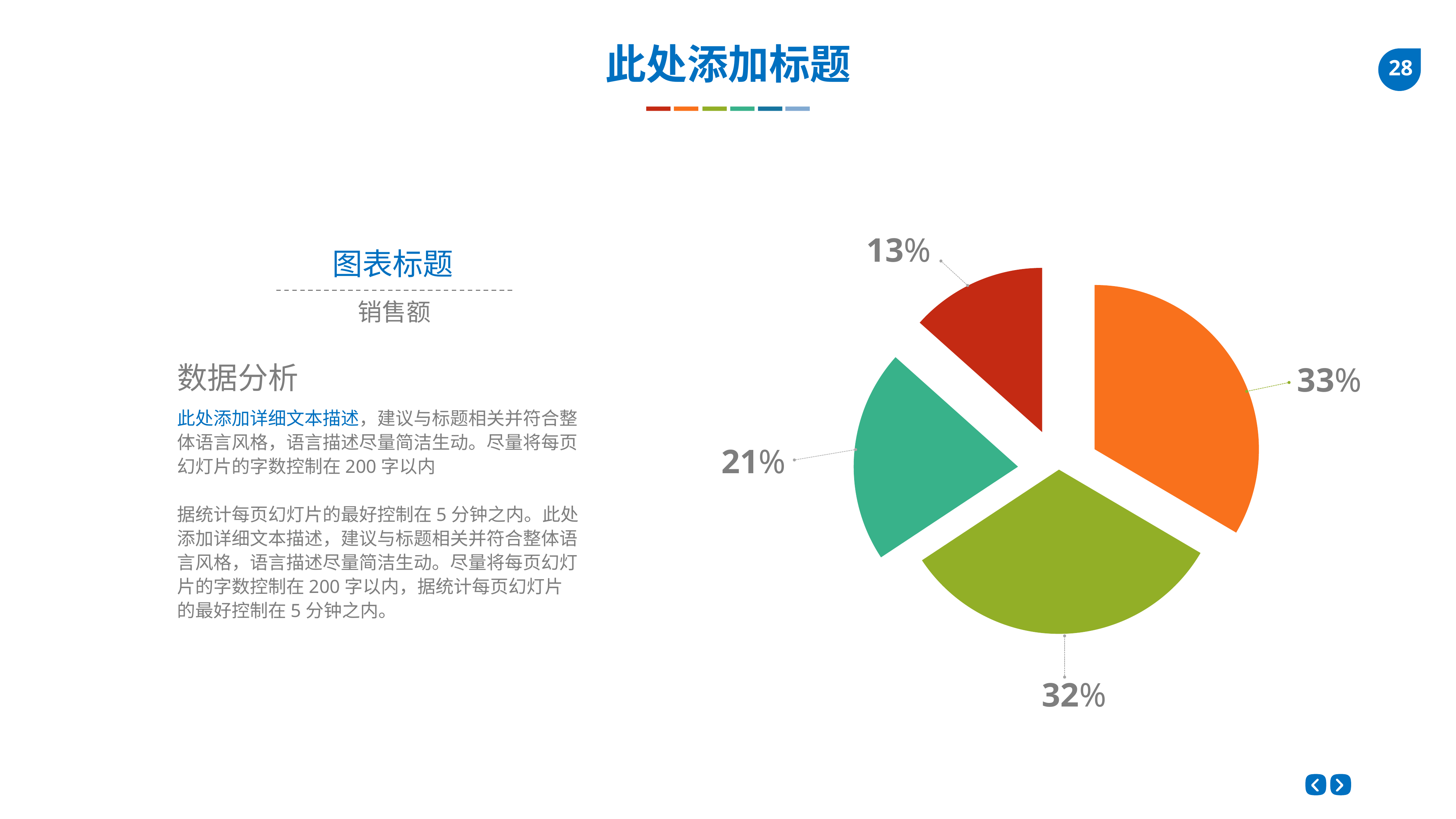
How many slices does the pie chart have? 4 What is the difference between the orange slice and the red slice in the pie chart? 20% What subtitle appears under the chart title 图表标题 on the slide? 销售额 What kind of chart is shown on the slide? pie chart What is the difference between the green slice and the teal slice in the pie chart? 11% What is the combined share of the orange and green slices in the pie chart? 65% What percentage is shown for the green slice of the pie chart? 32% Which is larger in the pie chart, the teal slice or the red slice? the teal slice Which slice of the pie chart has the smallest share? the red slice (13%) What percentage is shown for the teal slice of the pie chart? 21% What percentage is shown for the orange slice of the pie chart? 33% What percentage is shown for the red slice of the pie chart? 13%